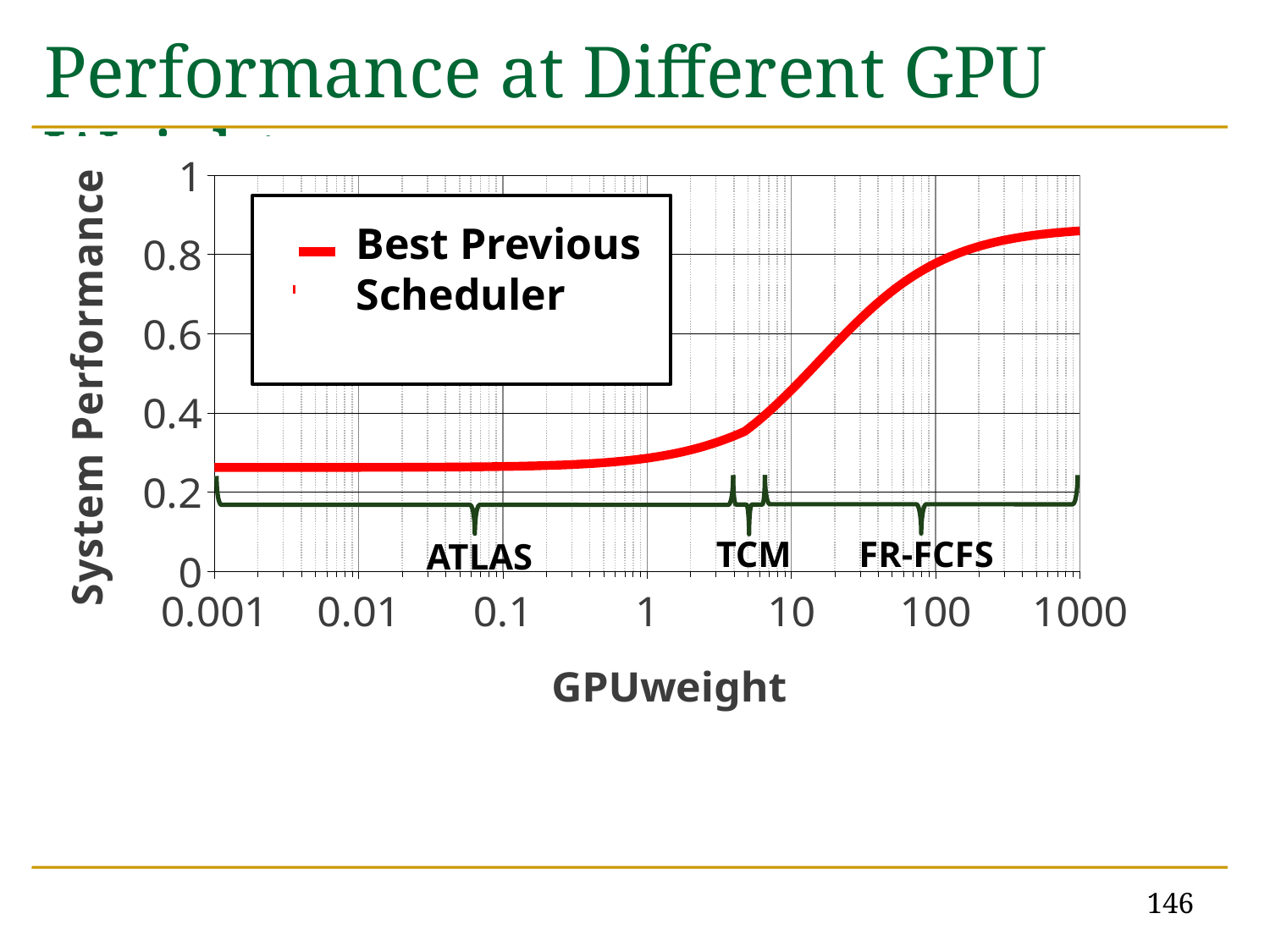
Is the System Performance value at GPUweight 1 greater or less than 0.4? less Is the System Performance value at GPUweight 100 greater or less than 0.6? greater What kind of chart is shown on the slide? line chart Which has the higher System Performance: GPUweight 0.01 or GPUweight 100? GPUweight 100 What is the label of the y axis? System Performance What is the label of the x axis? GPUweight Is the System Performance value at GPUweight 0.001 greater or less than 0.4? less Which scheduler name is written under the bracket covering the lowest GPUweight range? ATLAS Does the System Performance curve rise or fall as GPUweight increases from 0.001 to 1000? rise